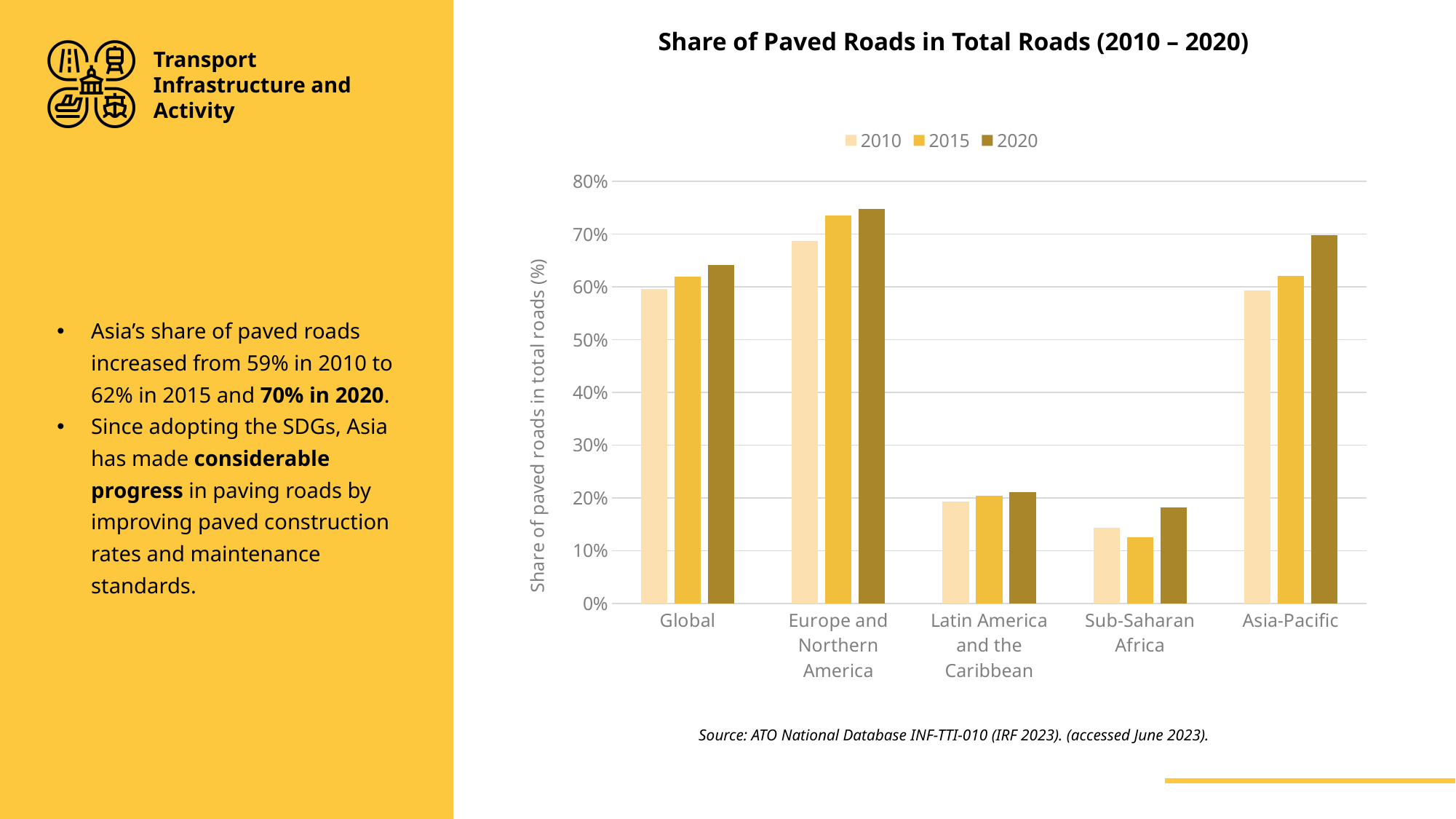
Which category has the highest share of paved roads in 2020? Europe and Northern America Is the 2010 value for Latin America and the Caribbean greater or less than 20%? less How many regions/categories are shown on the x axis? 5 Which category has the lowest share of paved roads in 2020? Sub-Saharan Africa What is the title of the chart? Share of Paved Roads in Total Roads (2010 – 2020) What kind of chart is shown on the slide? Bar chart Is the 2020 value for Europe and Northern America greater or less than 70%? greater Do the Asia-Pacific values rise or fall from 2010 to 2020? Rise Is the 2020 value for Sub-Saharan Africa greater or less than 20%? less How many series does the legend list? 3 Which is larger for Asia-Pacific: the 2010 value or the 2020 value? 2020 According to the slide, what was Asia's share of paved roads in 2020? 70%